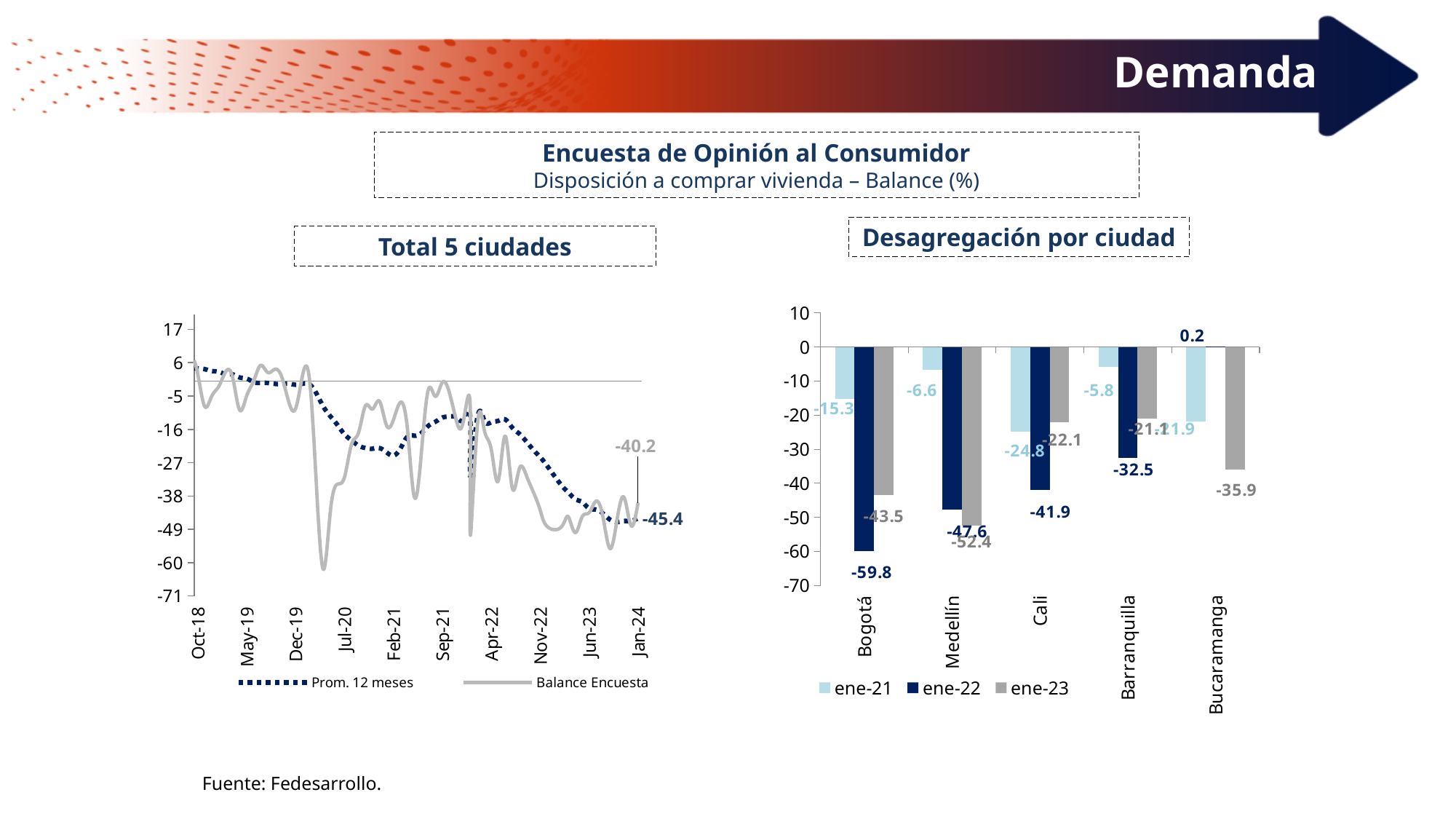
In the 'Total 5 ciudades' chart, what is the Prom. 12 meses value labelled at Jan-24? -45.4 In the 'Total 5 ciudades' chart, does the Prom. 12 meses series overall rise or fall from Oct-18 to Jan-24? fall In the 'Desagregación por ciudad' chart, what is the ene-22 value for Bucaramanga? 0.2 How many cities are shown on the 'Desagregación por ciudad' chart? 5 What kind of chart is the 'Desagregación por ciudad' chart? bar chart In the 'Desagregación por ciudad' chart, what is the ene-23 value for Medellín? -52.4 In the 'Total 5 ciudades' chart, what is the Balance Encuesta value labelled at Jan-24? -40.2 In the 'Desagregación por ciudad' chart, what is the difference between Cali's ene-22 value (-41.9) and its ene-23 value (-22.1)? 19.8 In the 'Desagregación por ciudad' chart, which city has the lowest ene-22 value? Bogotá In the 'Desagregación por ciudad' chart, is Medellín's ene-22 value or its ene-23 value lower? ene-23 In the 'Desagregación por ciudad' chart, what is the ene-22 value for Bogotá? -59.8 How many series does the legend of the 'Desagregación por ciudad' chart list? 3